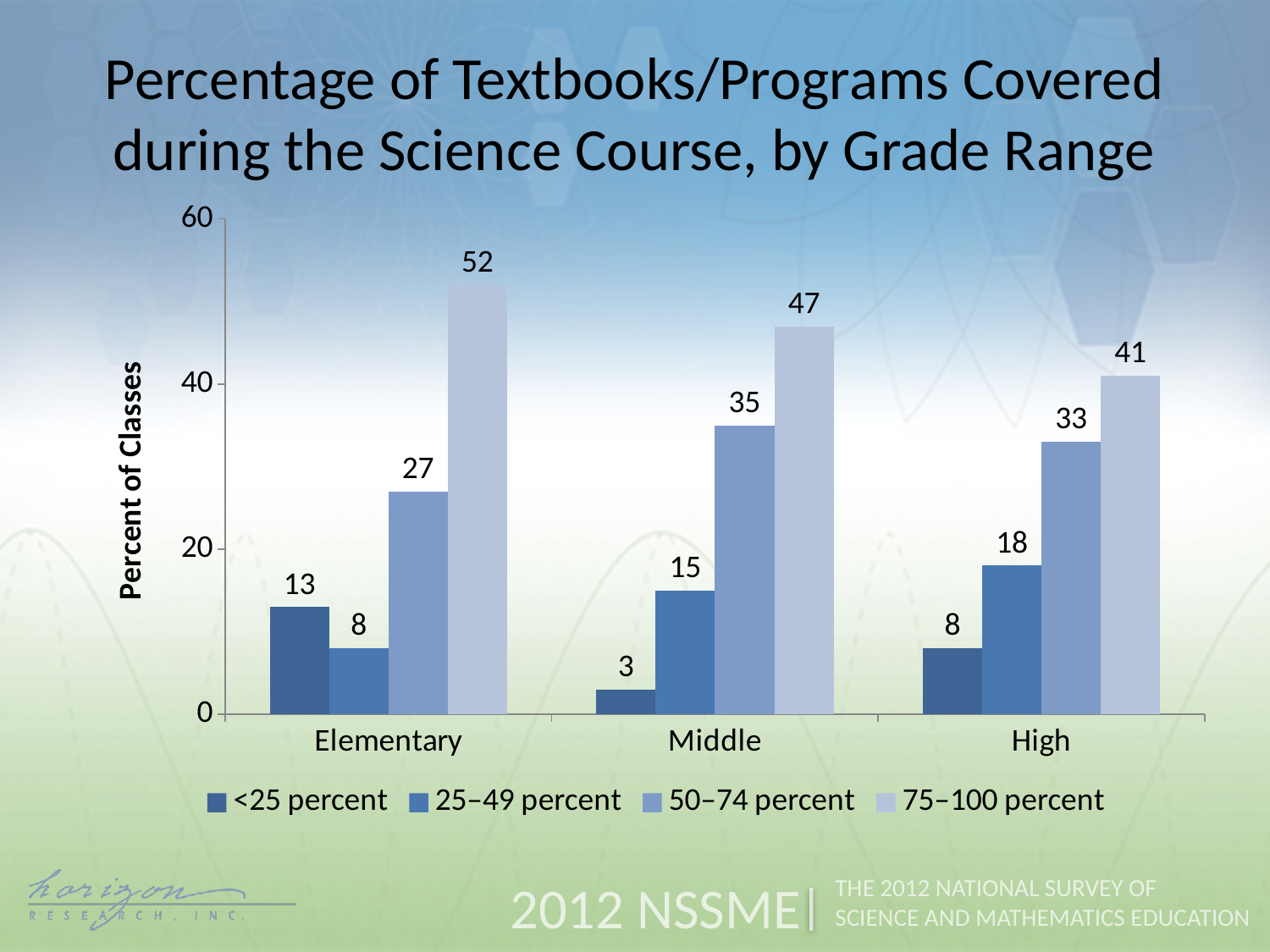
What is the value for the 75–100 percent series in the Elementary category? 52 What is the value for the <25 percent series in the Middle category? 3 What kind of chart is shown on the slide? bar chart What is the value for the 50–74 percent series in the High category? 33 Which grade range has the highest value for the 75–100 percent series? Elementary Which is larger: the 25–49 percent value for Middle or for High? High How many series does the legend list? 4 Which grade range has the lowest value for the <25 percent series? Middle What is the difference between the 75–100 percent values for Elementary and High? 11 What is the label of the y axis? Percent of Classes Is the value for the 50–74 percent series in the Middle category greater or less than 40? less How many grade range categories are shown on the x axis? 3